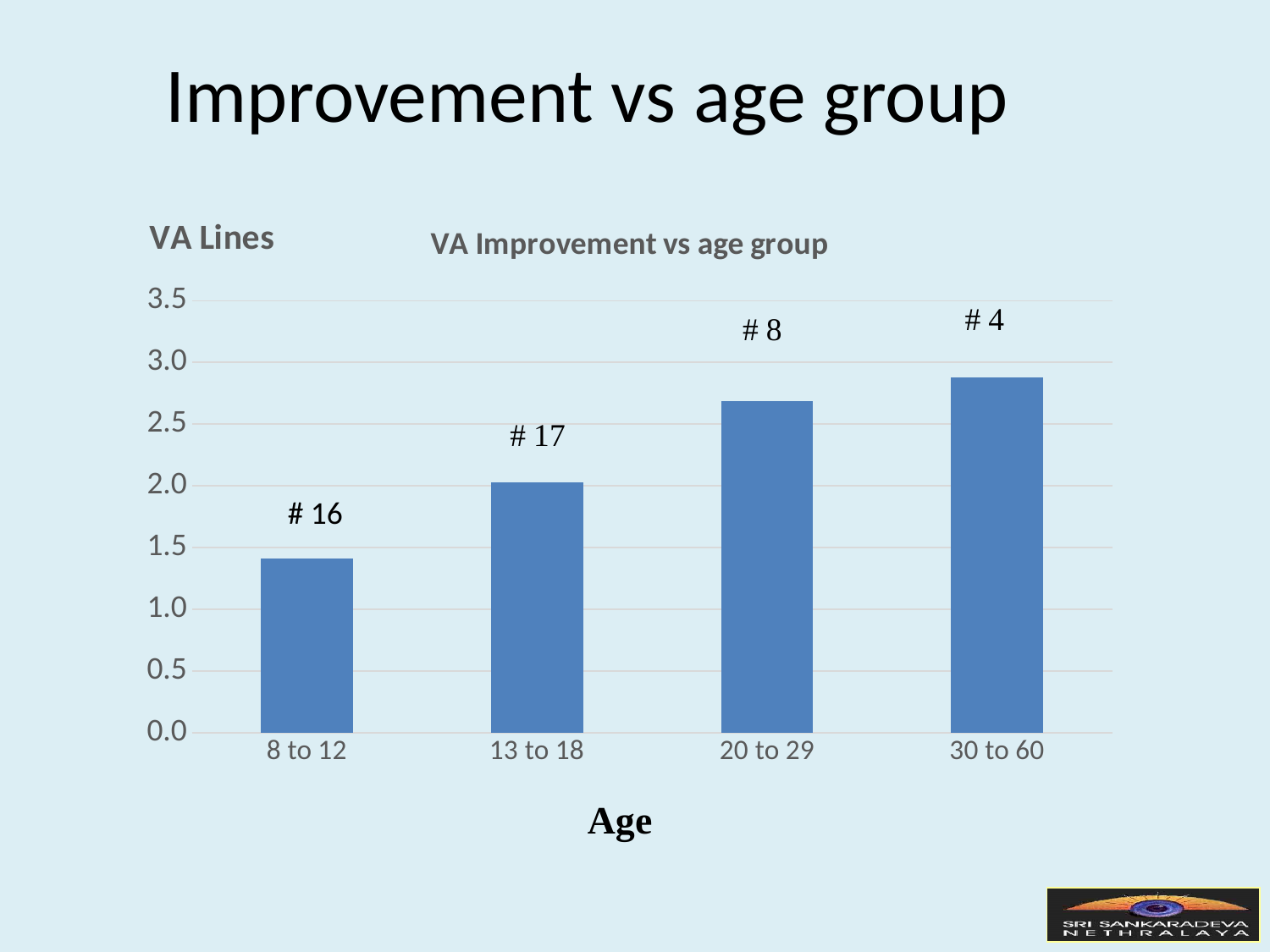
Which age group has the highest VA improvement? 30 to 60 Is the value for the 8 to 12 age group greater or less than 2.0? less Is the value for the 13 to 18 age group greater or less than 1.5? greater What annotation is printed above the bar for the 8 to 12 age group? # 16 What is the title of the chart? VA Improvement vs age group What kind of chart is shown on the slide? bar chart How many age groups are plotted on the x axis? 4 Which age group has the lowest VA improvement? 8 to 12 Is the value for the 20 to 29 age group greater or less than 2.5? greater Which has the larger VA improvement, the 13 to 18 group or the 20 to 29 group? 20 to 29 Do the values rise or fall as age group increases along the x axis? rise